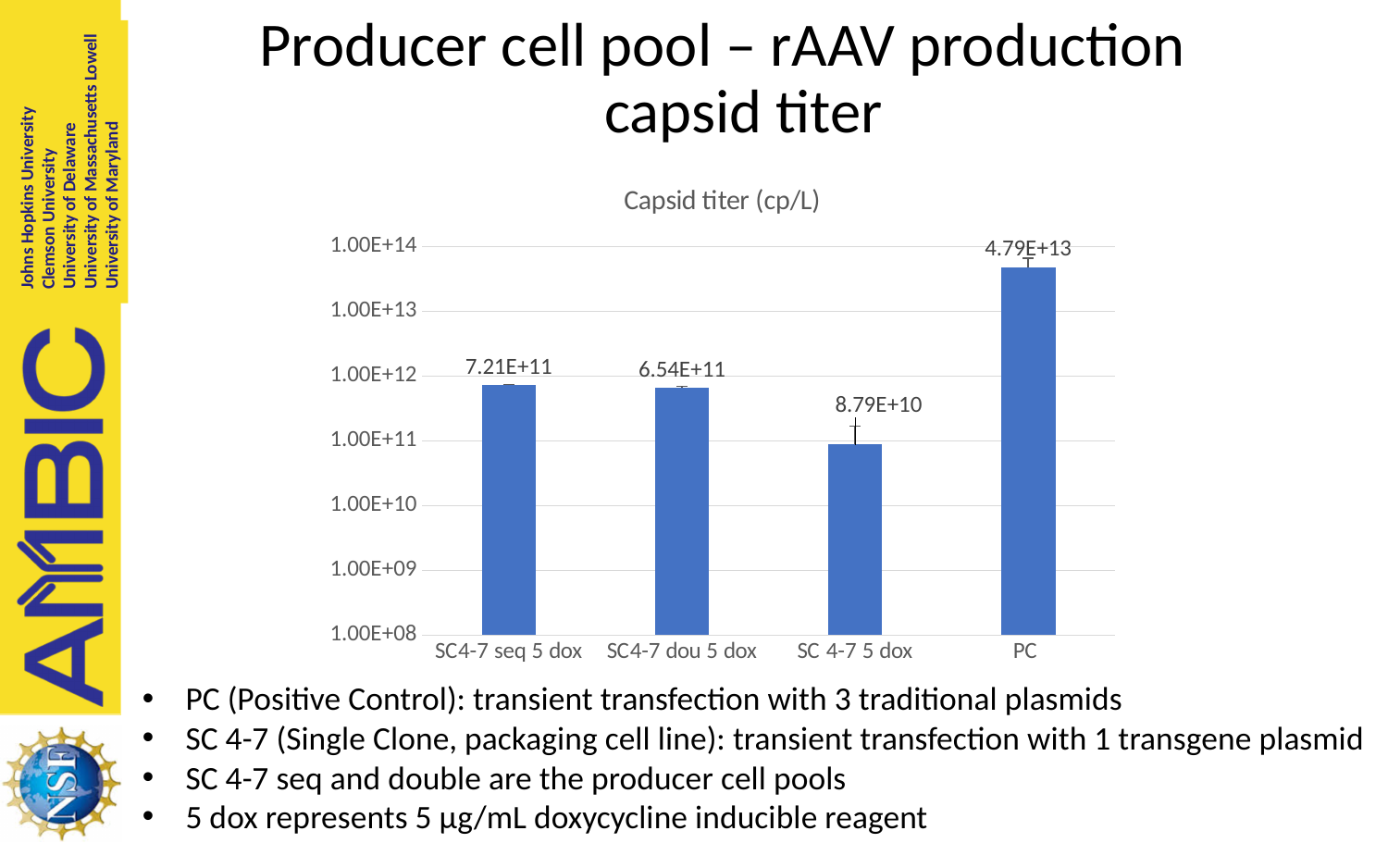
How many categories are shown on the x axis of the chart? 4 What is the capsid titer for SC 4-7 5 dox? 8.79E+10 Which has a higher capsid titer, SC4-7 seq 5 dox or SC 4-7 5 dox? SC4-7 seq 5 dox What type of chart is shown on the slide? Bar chart Which category has the lowest capsid titer? SC 4-7 5 dox What is the title of the chart? Capsid titer (cp/L) Is the capsid titer for PC greater or less than 1.00E+13? greater What is the capsid titer for PC? 4.79E+13 Which category has the highest capsid titer? PC Is the capsid titer for SC 4-7 5 dox greater or less than 1.00E+11? less What is the capsid titer for SC4-7 seq 5 dox? 7.21E+11 What is the capsid titer for SC4-7 dou 5 dox? 6.54E+11